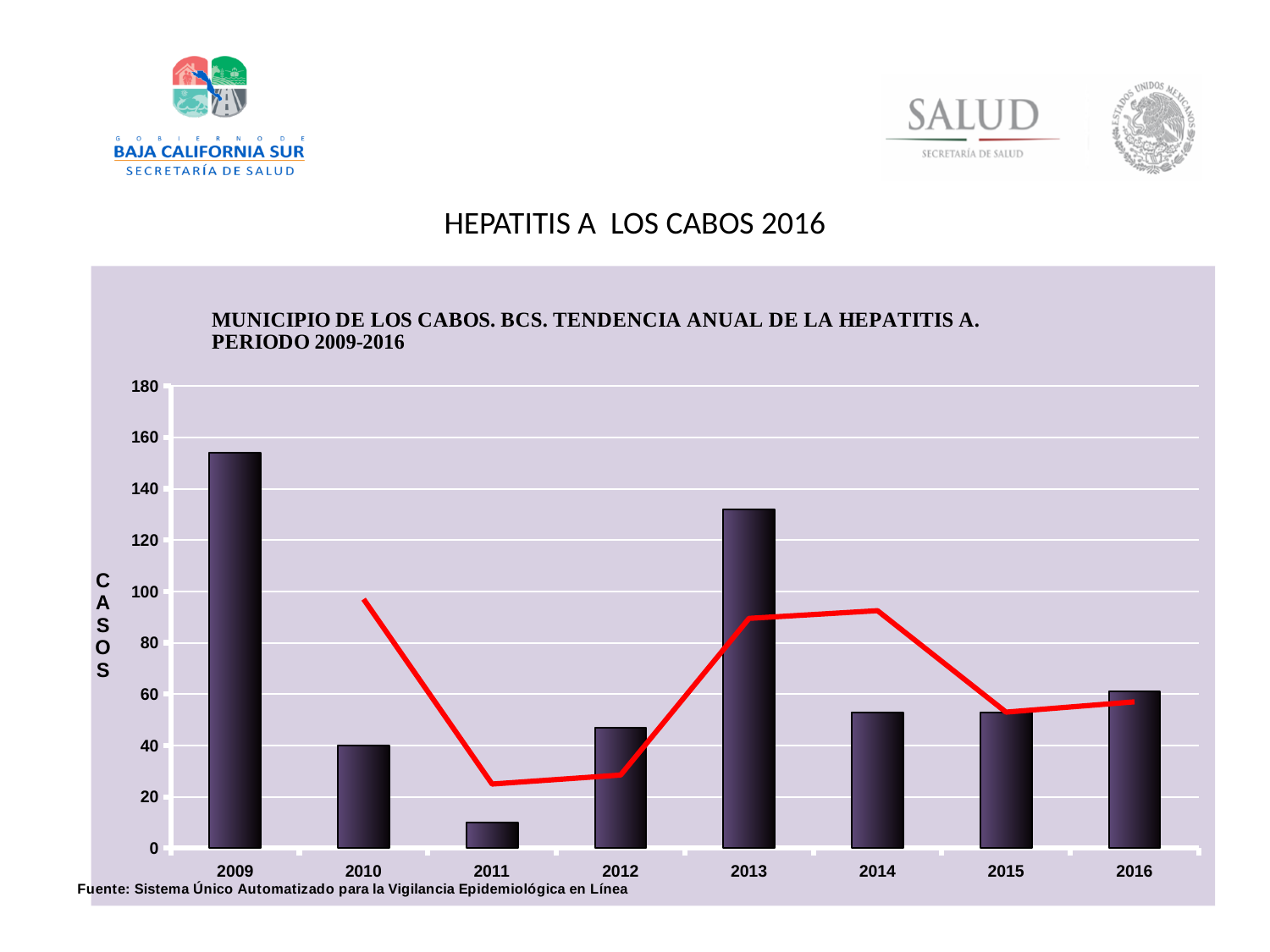
Which year has a higher bar, 2012 or 2013? 2013 Is the value for 2013 greater or less than 120? greater Which year has the lowest bar in the chart? 2011 How many years are shown on the x axis of the chart? 8 What period does the chart title say it covers? 2009-2016 Is the value for 2010 greater or less than 60? less What is the label on the vertical axis of the chart? CASOS Which year has the highest bar in the chart? 2009 Is the value for 2016 greater or less than 40? greater Which year has a higher bar, 2009 or 2013? 2009